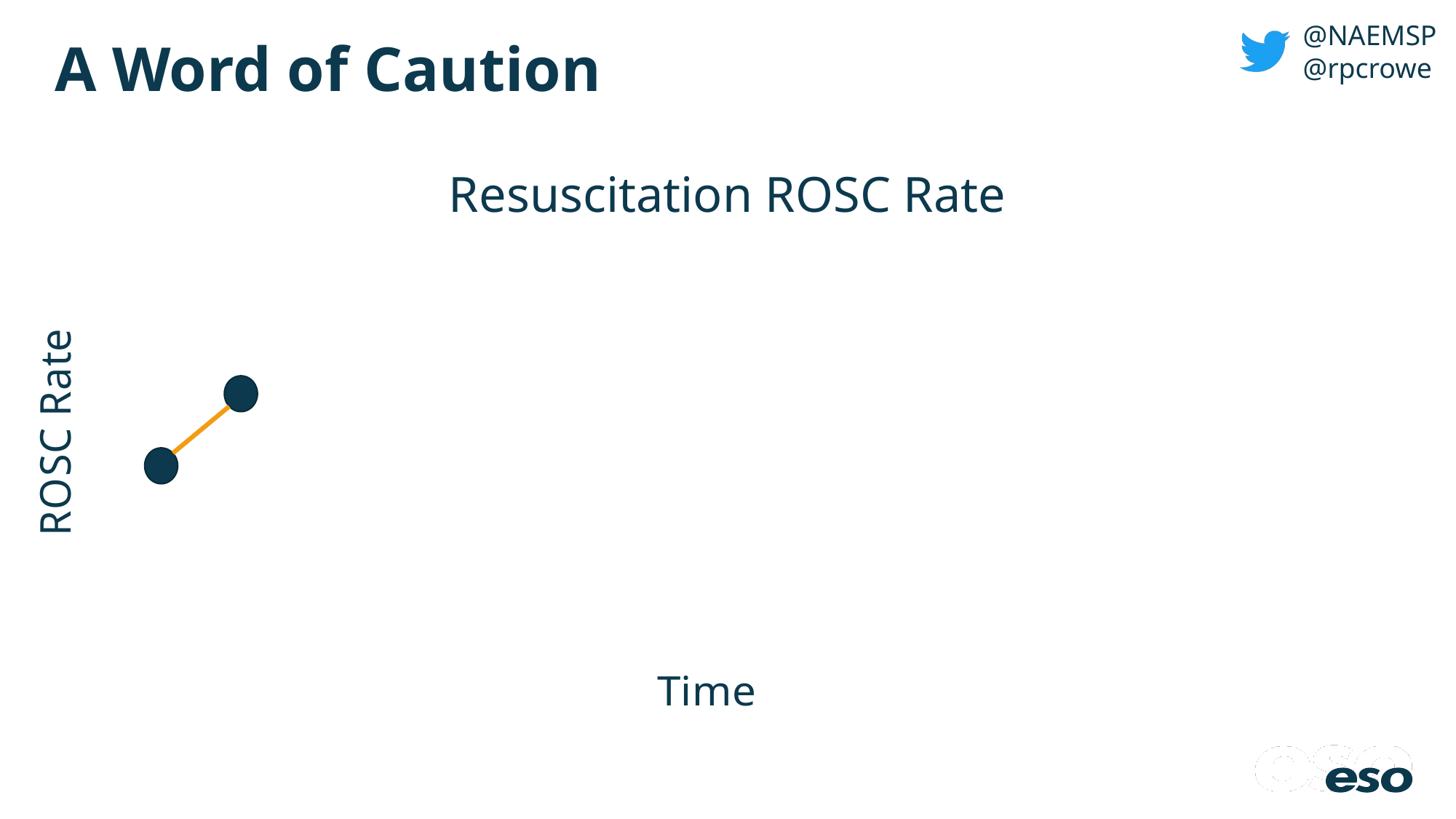
Which of the two plotted points has the higher ROSC Rate, the left one or the right one? The right one What is the label on the vertical axis of the chart? ROSC Rate How many data points are plotted on the chart? 2 What is the title of the chart? Resuscitation ROSC Rate Does the plotted line rise or fall from left to right along the Time axis? Rise What kind of chart is shown on the slide? Line chart